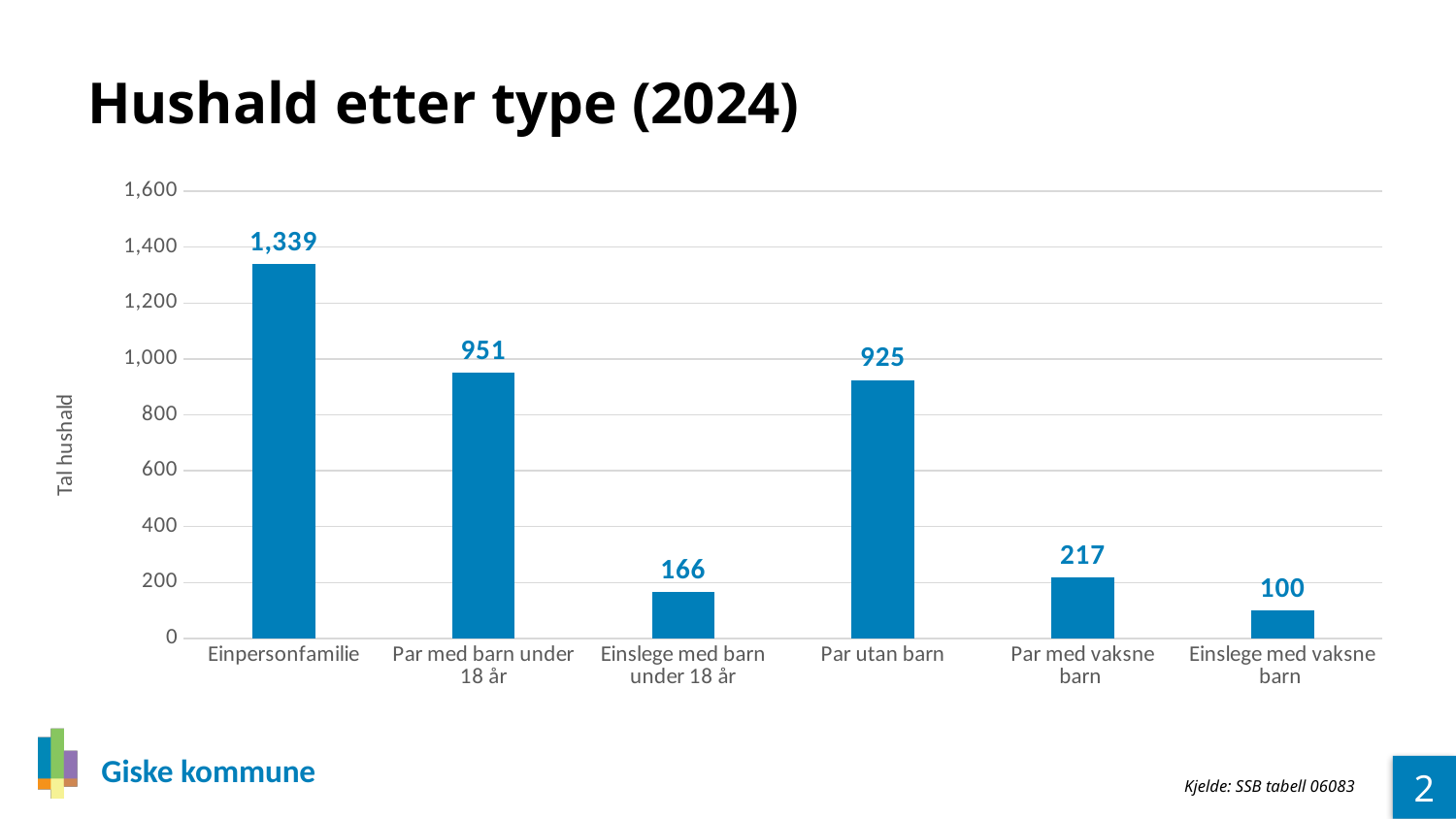
What is the value for Einslege med vaksne barn? 100 Which is larger: Par med vaksne barn or Einslege med barn under 18 år? Par med vaksne barn Is the value for Par med barn under 18 år greater or less than 1,000? less What is the title of the chart? Hushald etter type (2024) What is the label on the vertical axis? Tal hushald Which household type has the lowest value? Einslege med vaksne barn What is the value for Einpersonfamilie? 1,339 What is the difference between Par med barn under 18 år and Par utan barn? 26 What is the value for Par utan barn? 925 Which household type has the highest value? Einpersonfamilie How many household types are shown on the chart? 6 What kind of chart is shown on the slide? bar chart